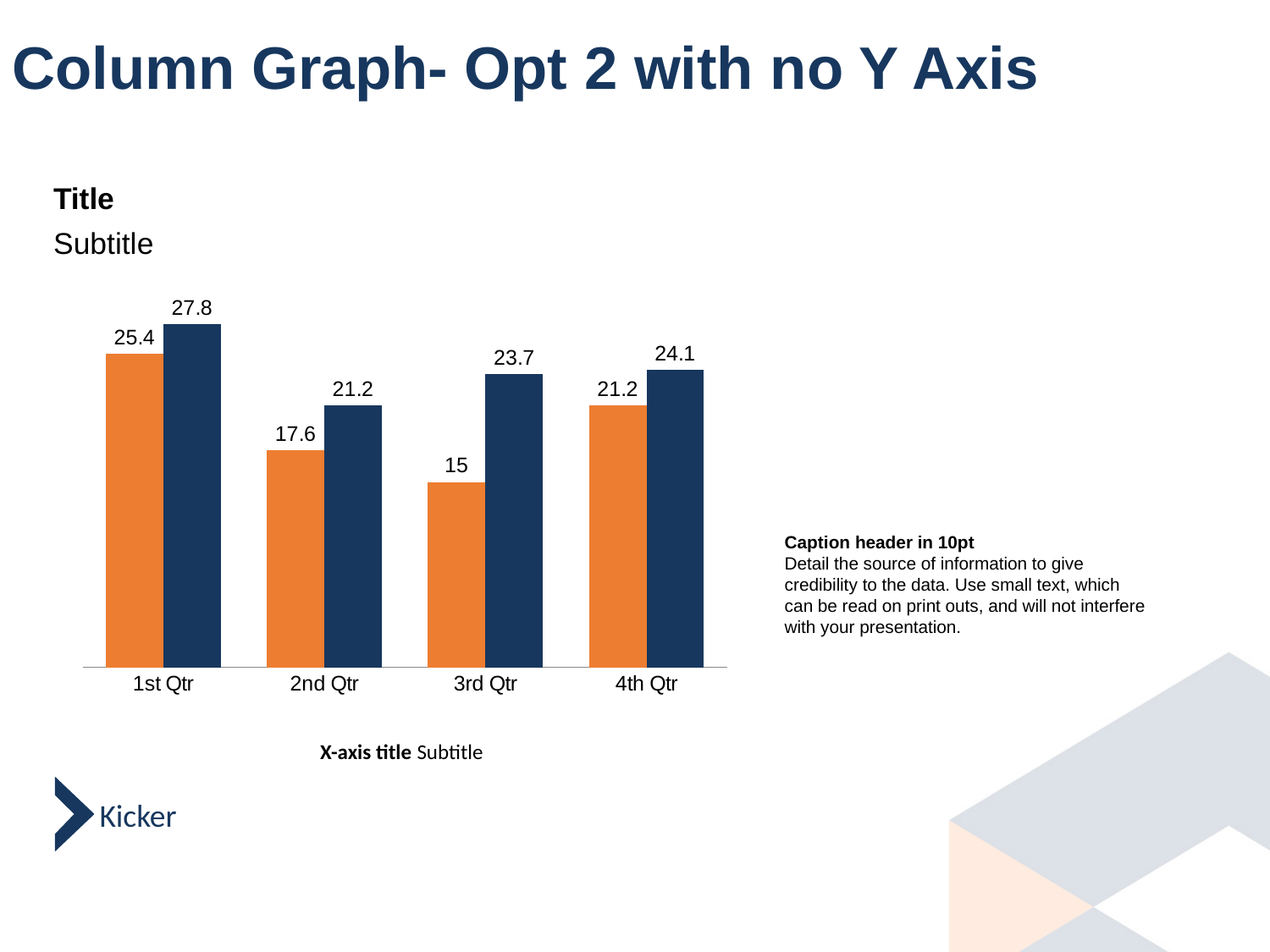
How many quarters are shown on the x axis? 4 What is the value of the orange bar for 1st Qtr? 25.4 Which quarter has the highest dark blue bar? 1st Qtr What is the x-axis title of the chart? X-axis title Subtitle Which is larger, the orange bar for 4th Qtr or the orange bar for 2nd Qtr? 4th Qtr What type of chart is shown on the slide? Bar chart What is the value of the orange bar for 3rd Qtr? 15 What is the value of the dark blue bar for 3rd Qtr? 23.7 What is the value of the dark blue bar for 4th Qtr? 24.1 Which quarter has the lowest orange bar? 3rd Qtr What is the difference between the orange bar for 1st Qtr and the orange bar for 3rd Qtr? 10.4 What is the difference between the dark blue and orange bars for 2nd Qtr? 3.6